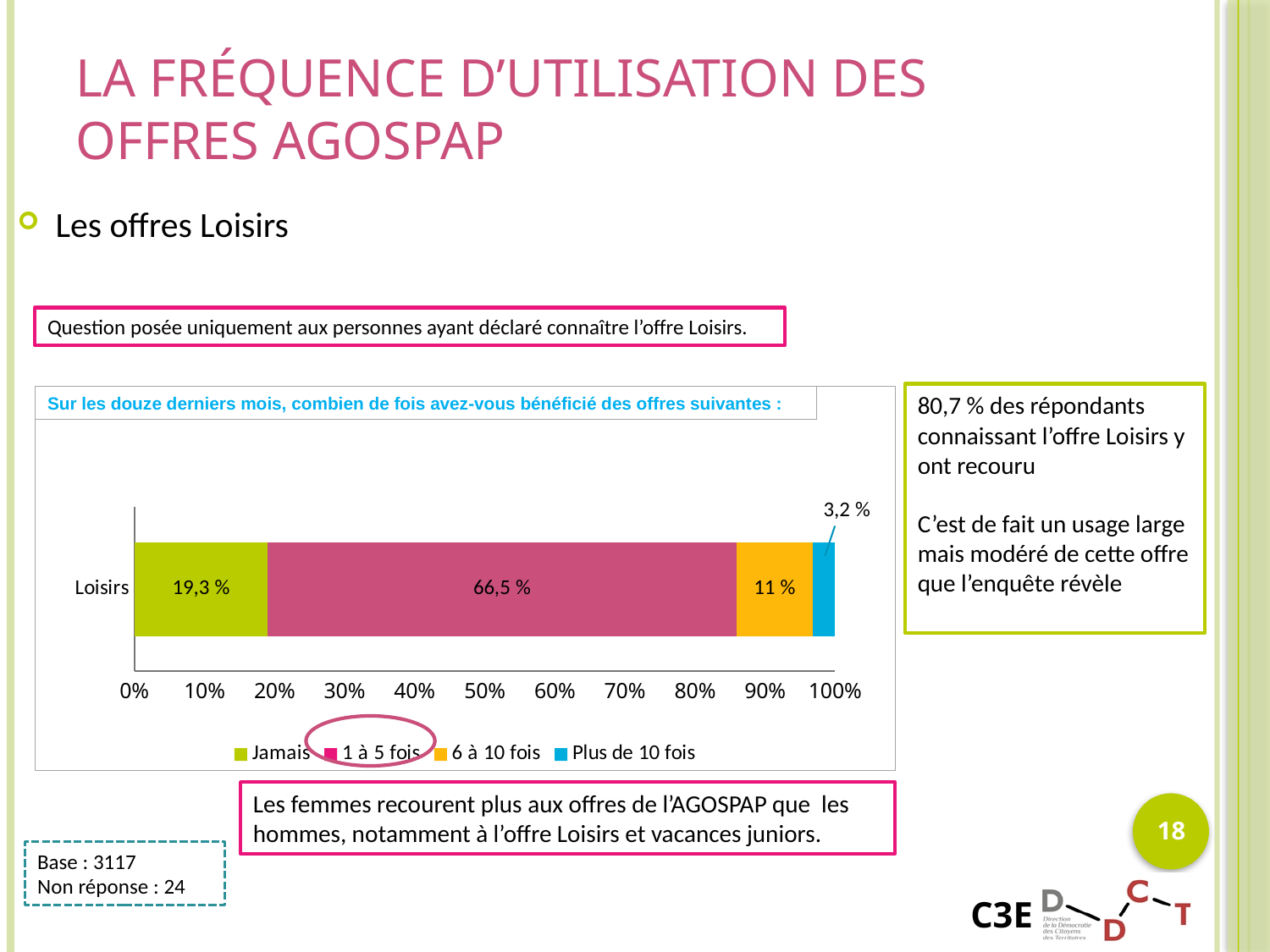
What is the value for "1 à 5 fois" in the Loisirs bar? 66,5 % What is the value for "Jamais" in the Loisirs bar? 19,3 % What kind of chart is shown on the slide? Stacked bar chart What is the value for "6 à 10 fois" in the Loisirs bar? 11 % Which legend entry is circled on the chart? 1 à 5 fois What is the value for "Plus de 10 fois" in the Loisirs bar? 3,2 % How many categories are plotted on the chart? 1 Which series has the smallest segment in the Loisirs bar? Plus de 10 fois How many series does the legend list? 4 Which series has the largest segment in the Loisirs bar? 1 à 5 fois What is the difference between the "1 à 5 fois" and "Jamais" values? 47,2 % Which is larger, the "Jamais" value or the "6 à 10 fois" value? Jamais